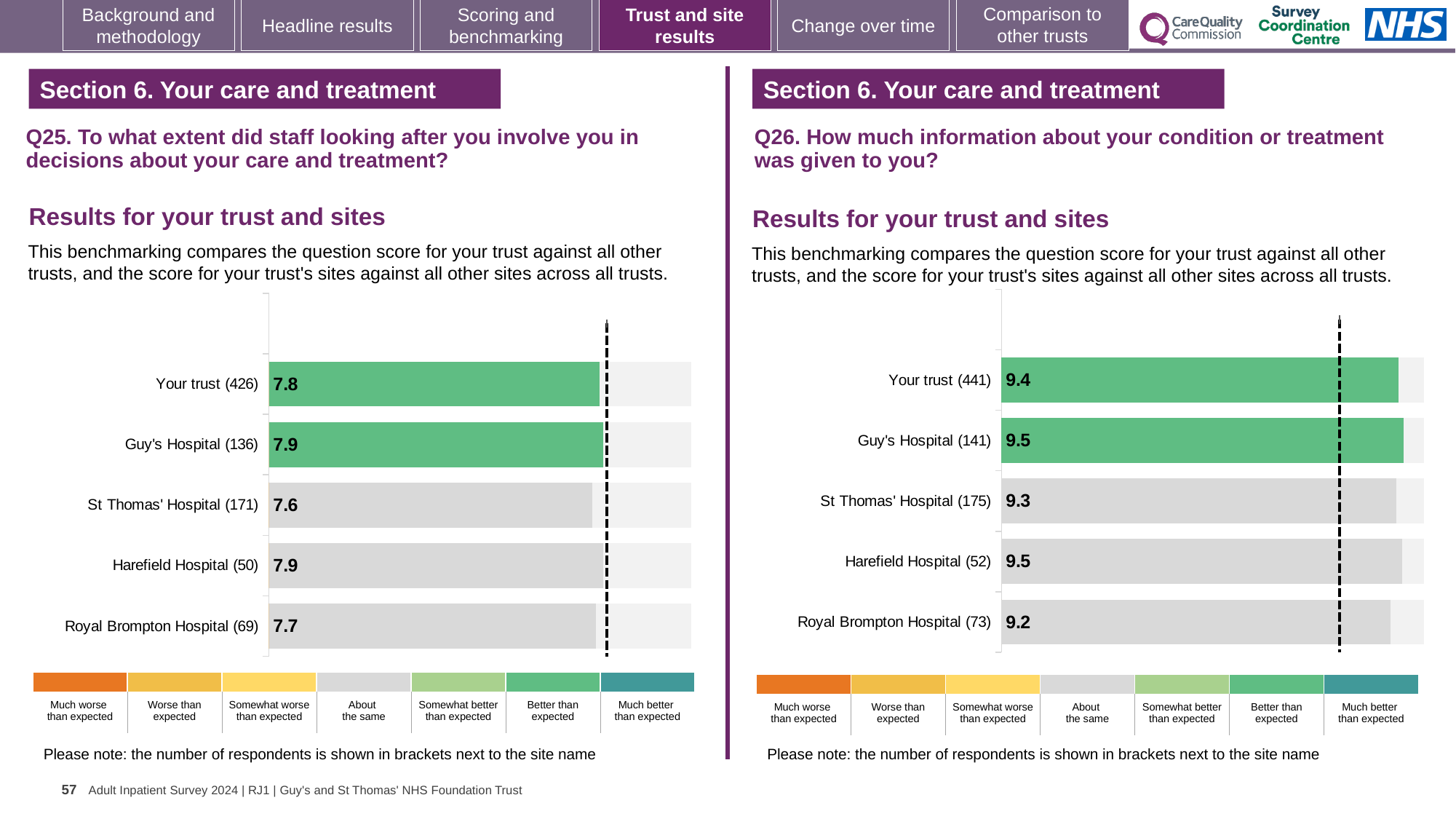
What kind of chart is used for the Q26 results? Bar chart In the Q26 chart, which is larger: the score for Your trust or the score for St Thomas' Hospital? Your trust In the Q26 chart, what is the score for Royal Brompton Hospital? 9.2 In the Q25 chart, how many respondents are shown for Guy's Hospital? 136 In the Q26 chart, what is the score for Guy's Hospital? 9.5 In the Q25 chart, which site has the lowest score? St Thomas' Hospital In the Q25 chart, what is the score for Your trust? 7.8 In the Q26 chart, what is the difference between the scores for Guy's Hospital and Royal Brompton Hospital? 0.3 In the Q26 chart, which site has the lowest score? Royal Brompton Hospital In the Q25 chart, what is the difference between the scores for Harefield Hospital and Royal Brompton Hospital? 0.2 How many bars are plotted in the Q25 chart? 5 In the Q25 chart, what is the score for St Thomas' Hospital? 7.6